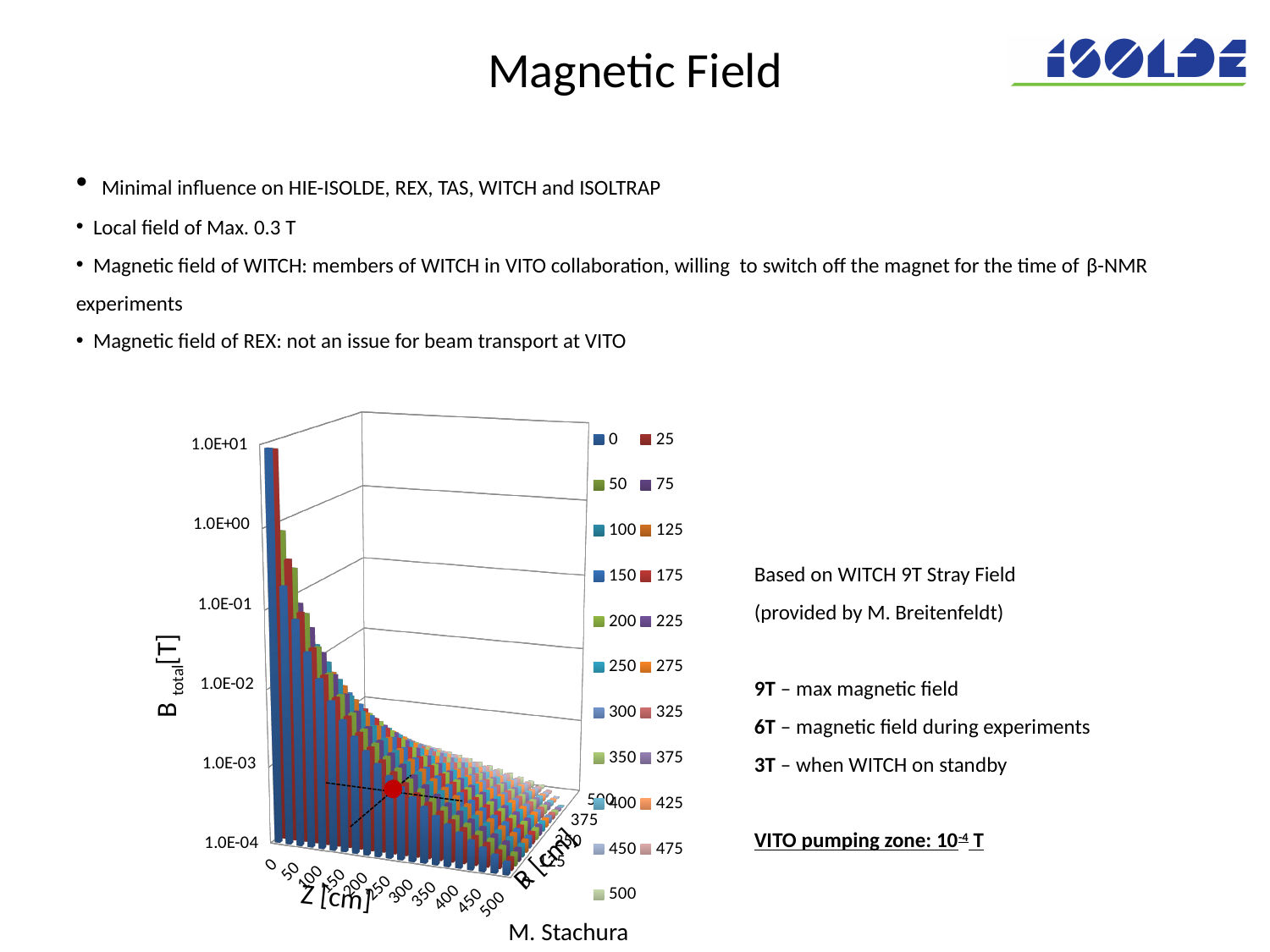
Is the value for series 0 at Z = 500 greater or less than 1.0E-02? less Which is larger for series 0: the value at Z = 50 or the value at Z = 400? Z = 50 Do the plotted values rise or fall as Z increases along the x axis? fall How many series does the chart's legend list? 21 What is the lowest tick value shown on the vertical axis of the chart? 1.0E-04 What is the label of the vertical axis of the chart? B total [T] Is the value for series 0 at Z = 0 greater or less than 1.0E+00? greater What is the highest tick value shown on the vertical axis of the chart? 1.0E+01 What is the label of the horizontal (front) axis of the chart? Z [cm] At which Z value is the bar for series 0 highest? 0 What kind of chart is shown on the slide? bar chart